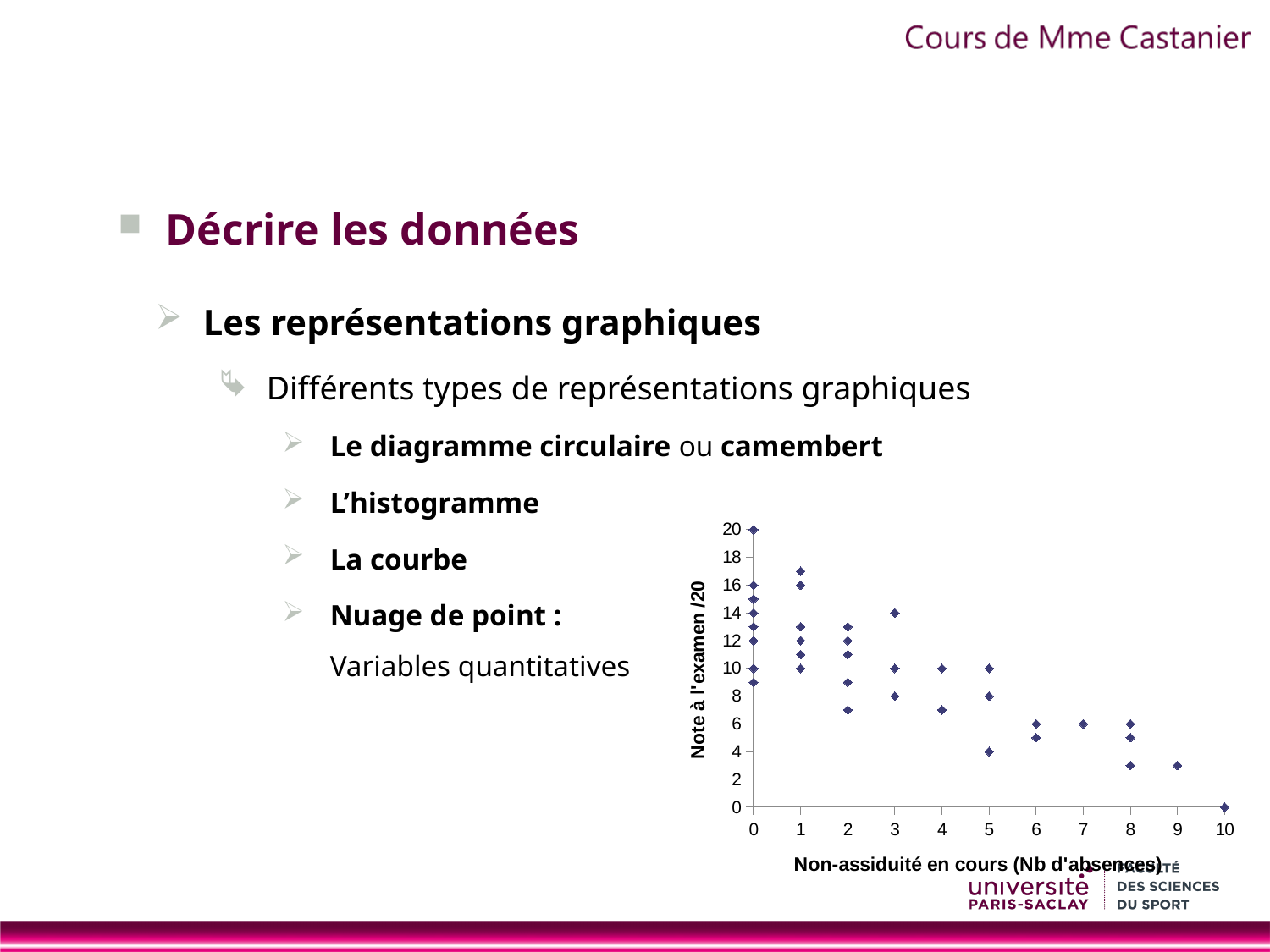
Which is larger: the exam mark at 7 absences or the exam mark at 9 absences? 7 absences What is the highest exam mark plotted on the chart? 20 What kind of chart is shown on the slide? scatter plot What is the label of the x axis of the chart? Non-assiduité en cours (Nb d'absences) What is the exam mark of the point plotted at 10 absences? 0 Is the exam mark of the point at 9 absences greater or less than 10? less What is the lowest exam mark plotted on the chart? 0 How many absences does the point with the highest exam mark have? 0 Do the exam marks generally rise or fall as the number of absences increases along the x axis? fall What is the exam mark of the point plotted at 7 absences? 6 What is the label of the y axis of the chart? Note à l'examen /20